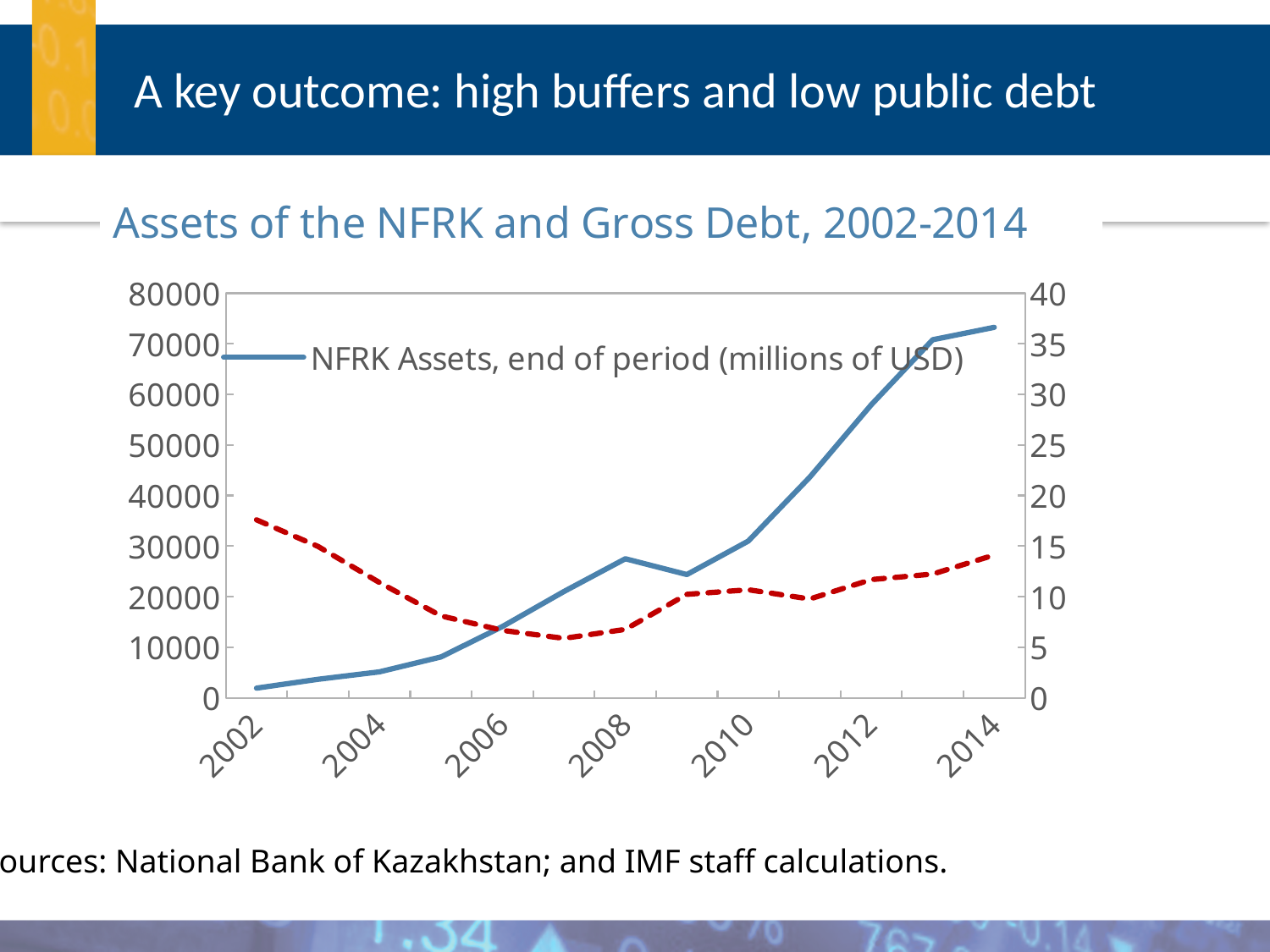
What kind of chart is shown on the slide? line chart What series name is shown in the chart's legend? NFRK Assets, end of period (millions of USD) Is the value for NFRK Assets in 2014 greater or less than 70000? greater What is the title of the chart? Assets of the NFRK and Gross Debt, 2002-2014 Is the value for NFRK Assets in 2012 greater or less than 50000? greater In which year are NFRK Assets lowest? 2002 In which year are NFRK Assets highest? 2014 How many series does the chart's legend list? 1 Which year has higher NFRK Assets, 2008 or 2009? 2008 Is the value for NFRK Assets in 2002 greater or less than 10000? less Do NFRK Assets overall rise or fall from 2002 to 2014? rise